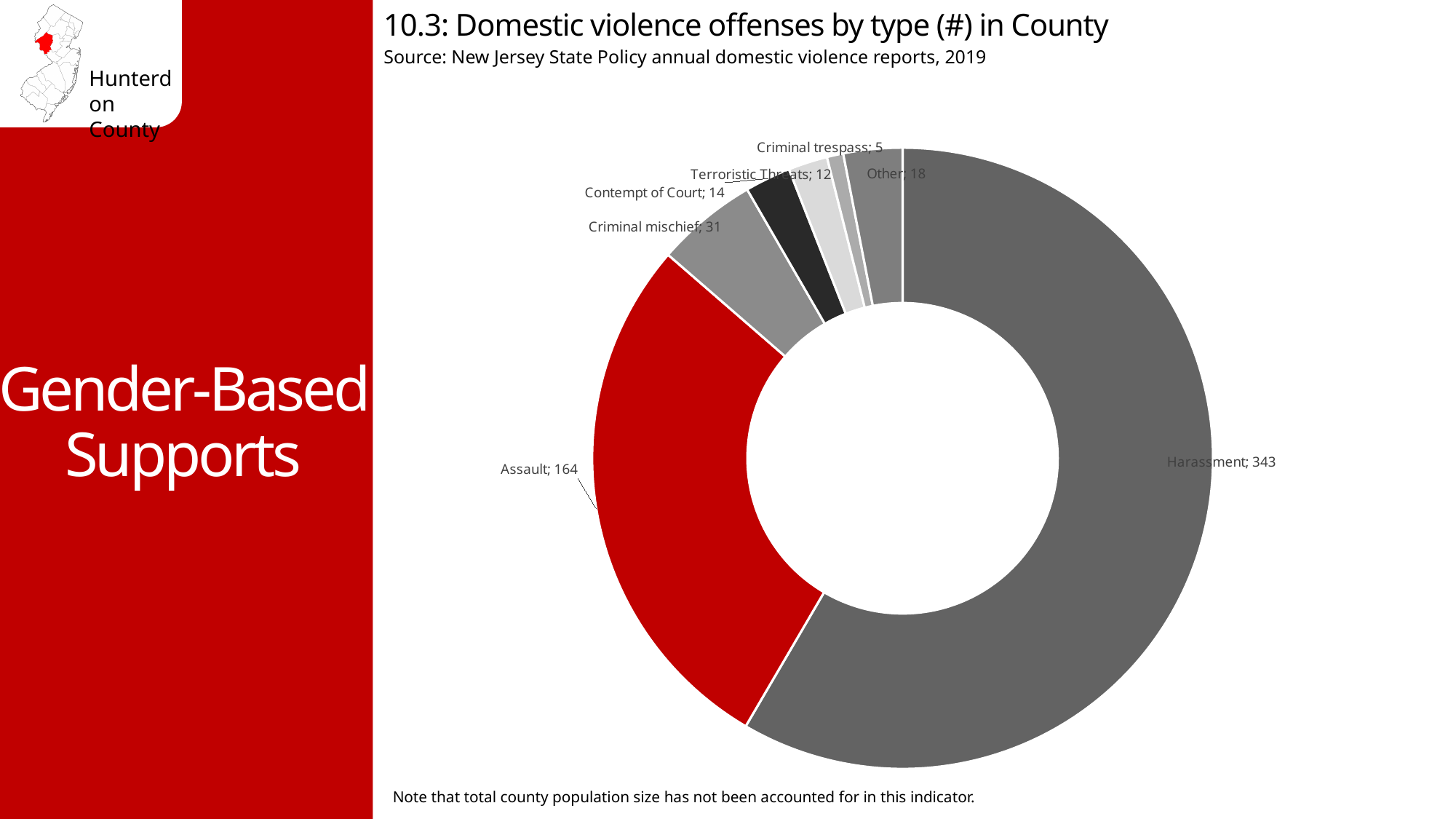
What is the value for Terroristic Threats? 12 Which offense type has the smallest slice on the chart? Criminal trespass What kind of chart is shown on the slide? Doughnut chart How many offense types (slices) are shown on the chart? 7 Which offense type has the largest slice on the chart? Harassment What is the difference between the Harassment and Assault values? 179 What is the value for Criminal mischief? 31 How many domestic violence offenses of type Harassment are shown on the chart? 343 What is the value for Contempt of Court? 14 Which is larger, the value for Other or the value for Contempt of Court? Other What is the total number of offenses across all slices of the chart? 587 What is the value for Assault on the chart? 164